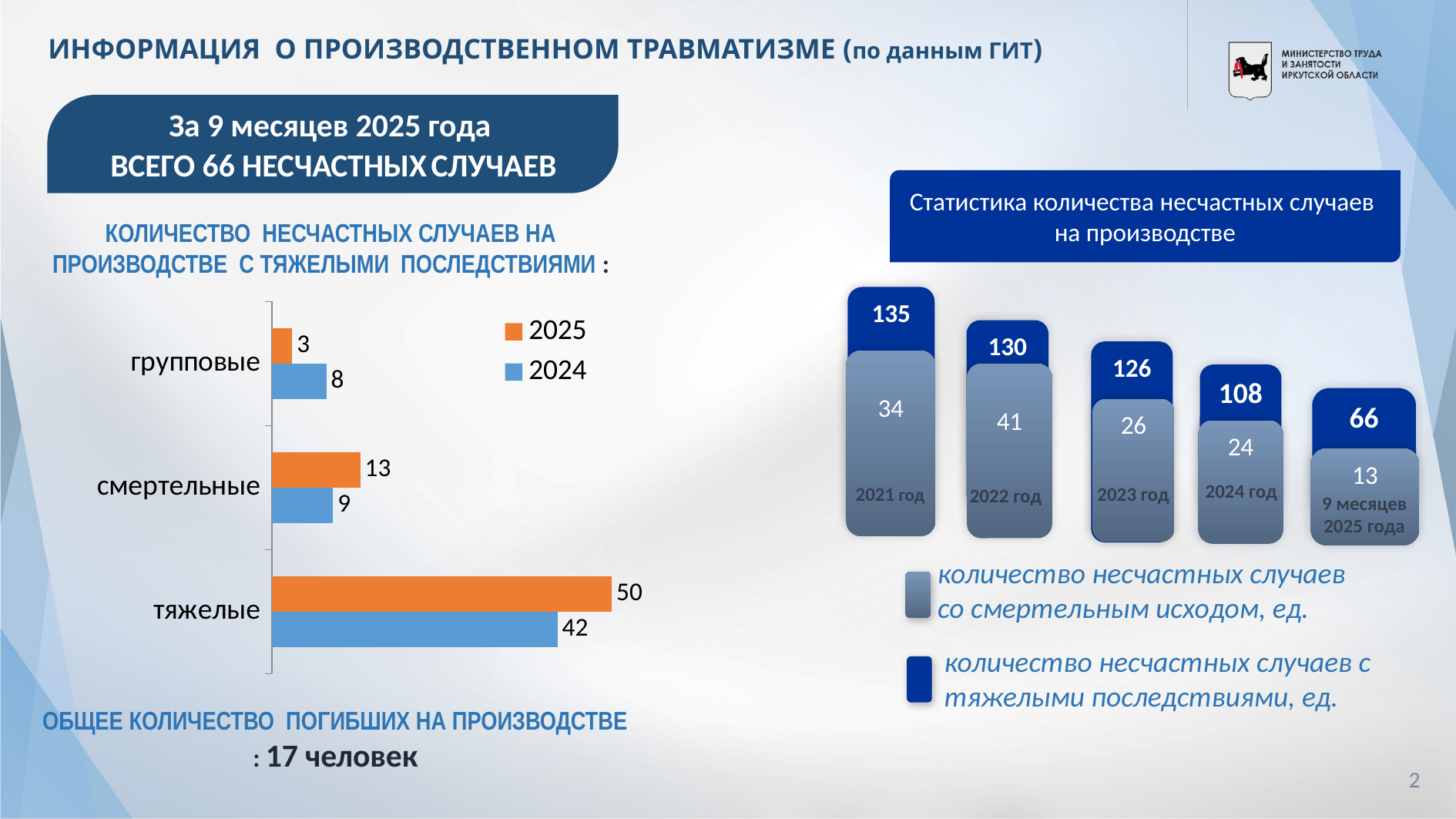
In the bar chart on the left, how many categories are shown? 3 In the bar chart on the left, which category has the highest value for 2024? тяжелые In the chart on the right titled 'Статистика количества несчастных случаев на производстве', which year has the highest number of fatal accidents? 2022 год In the bar chart on the left, what is the value for смертельные in 2024? 9 In the chart on the right titled 'Статистика количества несчастных случаев на производстве', what is the total number of accidents with severe consequences for 2023 год? 126 What type of chart is shown on the left of the slide? bar chart In the bar chart on the left, what is the difference between the 2025 and 2024 values for тяжелые? 8 In the bar chart on the left, what is the value for групповые in 2025? 3 In the bar chart on the left, what is the value for тяжелые in 2025? 50 In the bar chart on the left, which category has the lowest value for 2025? групповые In the bar chart on the left, which is larger for групповые: the 2025 value or the 2024 value? 2024 In the bar chart on the left, how many series does the legend list? 2